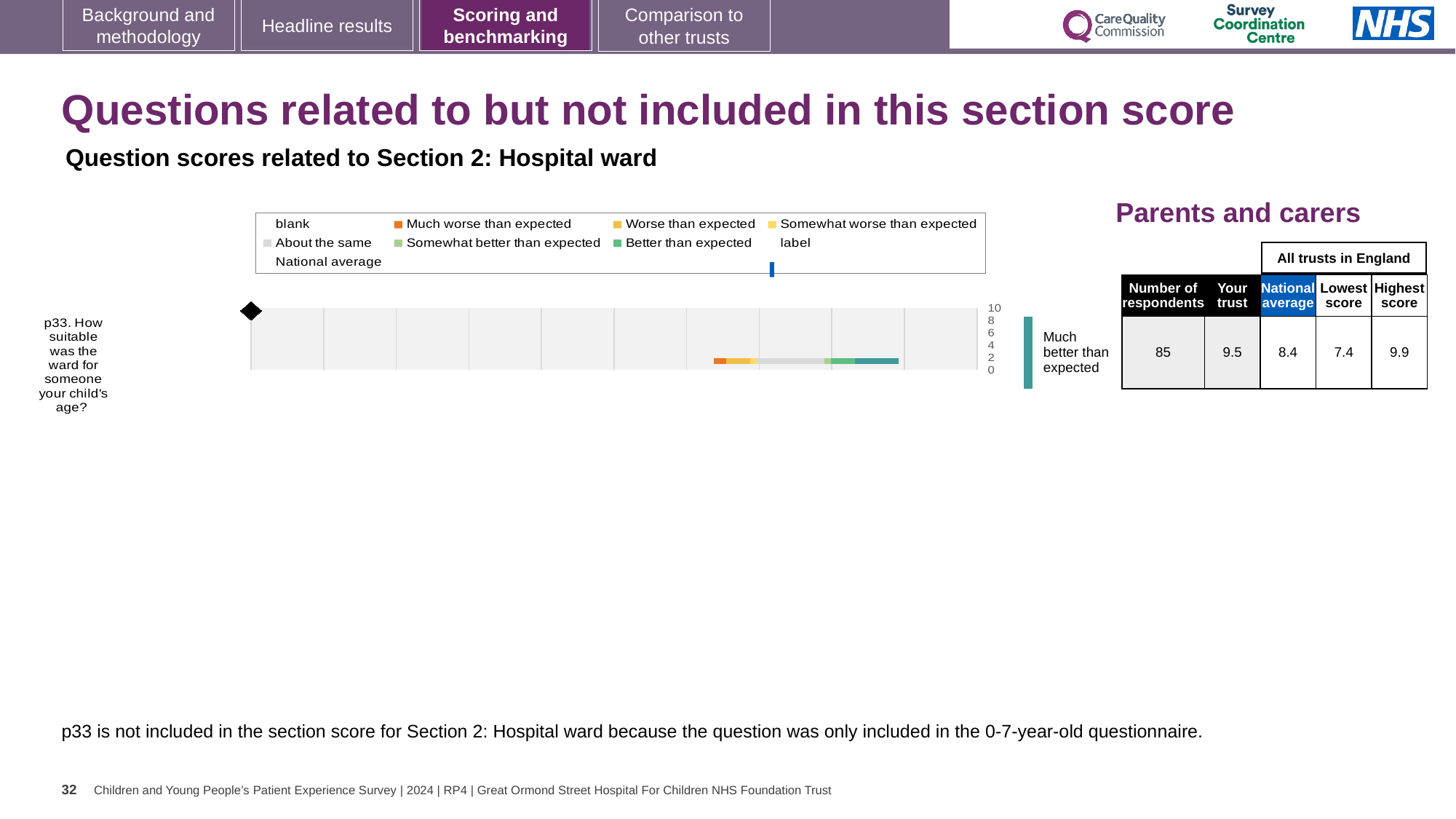
By how much does the trust's score for p33 exceed the national average? 1.1 How many questions (categories) are plotted in the chart? 1 According to the table, what is the lowest score among all trusts in England for p33? 7.4 What is the difference between the highest and lowest scores among all trusts in England for p33? 2.5 According to the table next to the chart, what is the 'Your trust' score for p33? 9.5 What benchmark rating is shown for p33 to the right of the chart? Much better than expected Which is higher for p33: the trust's score or the national average? Your trust What colour does the legend use for 'Much worse than expected'? Orange How many respondents answered question p33? 85 What kind of chart is used to show the p33 question score? Bar chart According to the table, what is the highest score among all trusts in England for p33? 9.9 According to the table next to the chart, what is the national average score for p33? 8.4